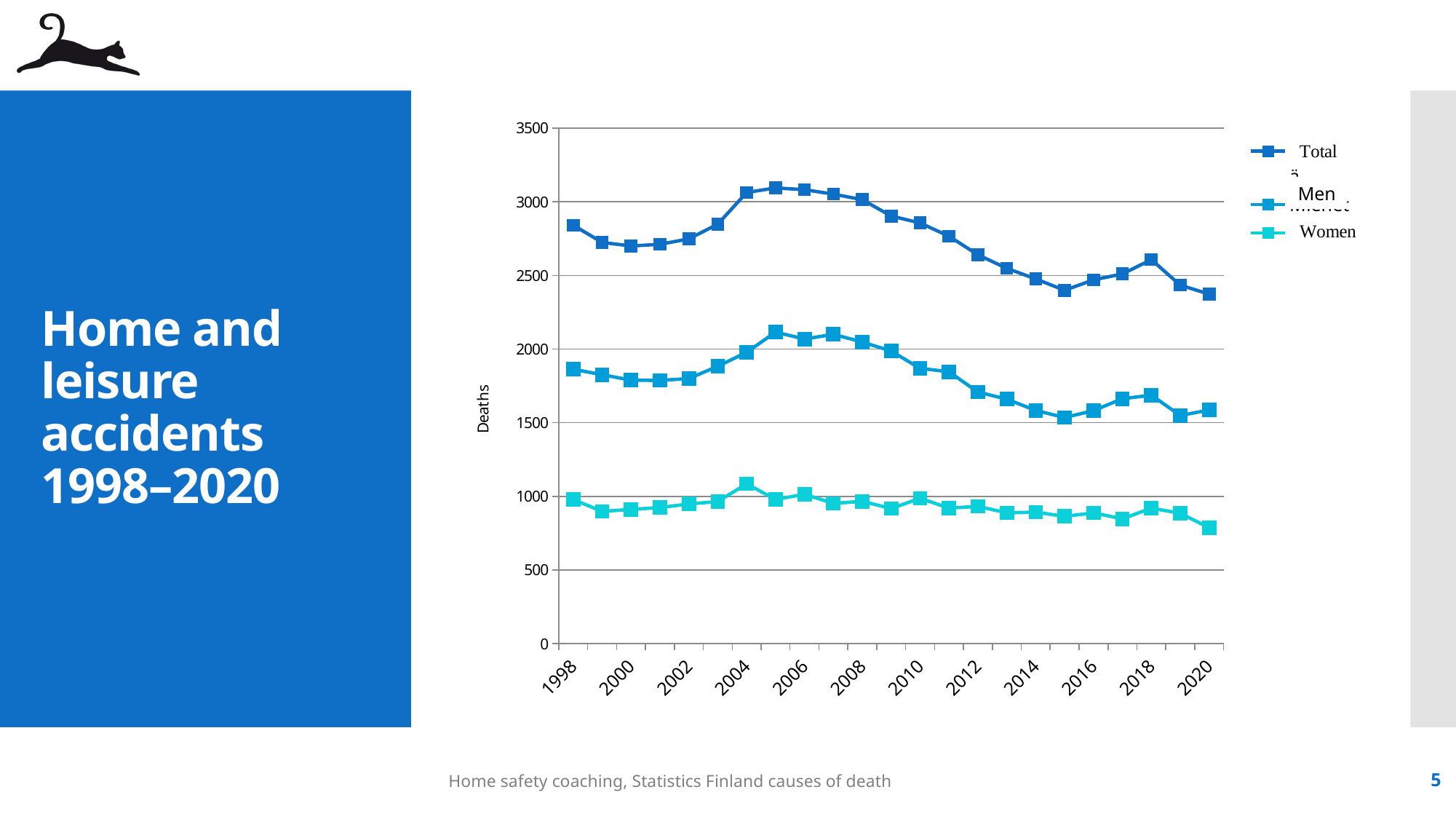
How many years are plotted along the x axis, from 1998 to 2020? 23 Is the value for Total in 2020 greater or less than 2500? less What is the label of the vertical axis? Deaths Which series is plotted with the lightest (turquoise) line? Women Is the value for Total in 2005 greater or less than 3000? greater Does the Total series rise or fall between 2005 and 2015? fall In which year does the Women series reach its highest value? 2004 How many series does the legend list? 3 In which year does the Women series reach its lowest value? 2020 Is the value for Women in 2020 greater or less than 1000? less What kind of chart is shown on the slide? line chart